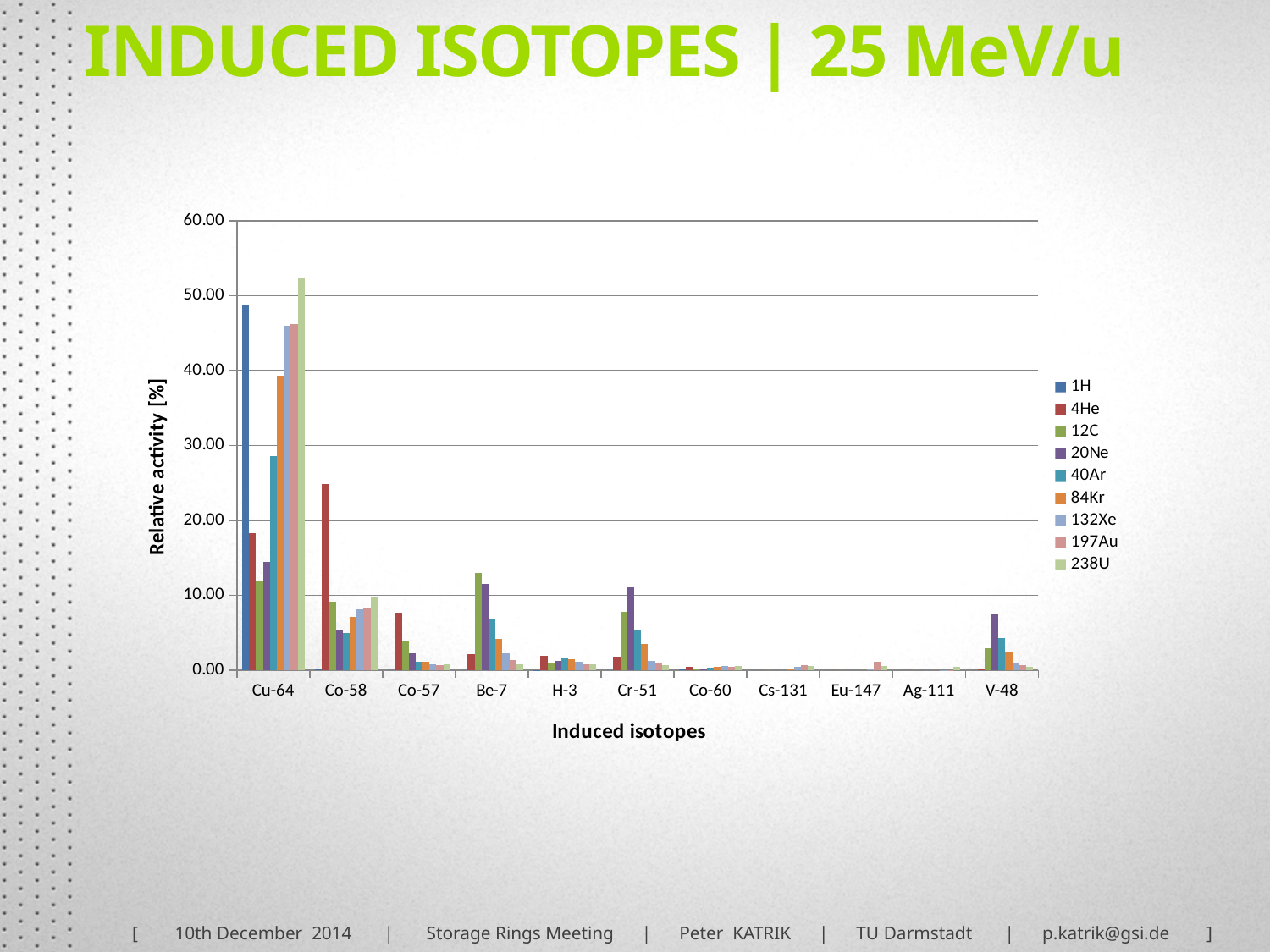
What is the label of the x axis? Induced isotopes How many induced isotopes (categories) are shown on the x axis? 11 What kind of chart is shown on the slide? bar chart Which induced isotope has the highest relative activity overall? Cu-64 Is the value for 238U at Cu-64 greater or less than 50.00? greater For Cr-51, which series has the highest relative activity? 20Ne What is the label of the y axis? Relative activity [%] For Co-58, which series has the highest relative activity? 4He Is the value for 4He at Co-58 greater or less than 20.00? greater How many series does the legend list? 9 Which is larger: the 1H value at Cu-64 or the 4He value at Co-58? 1H at Cu-64